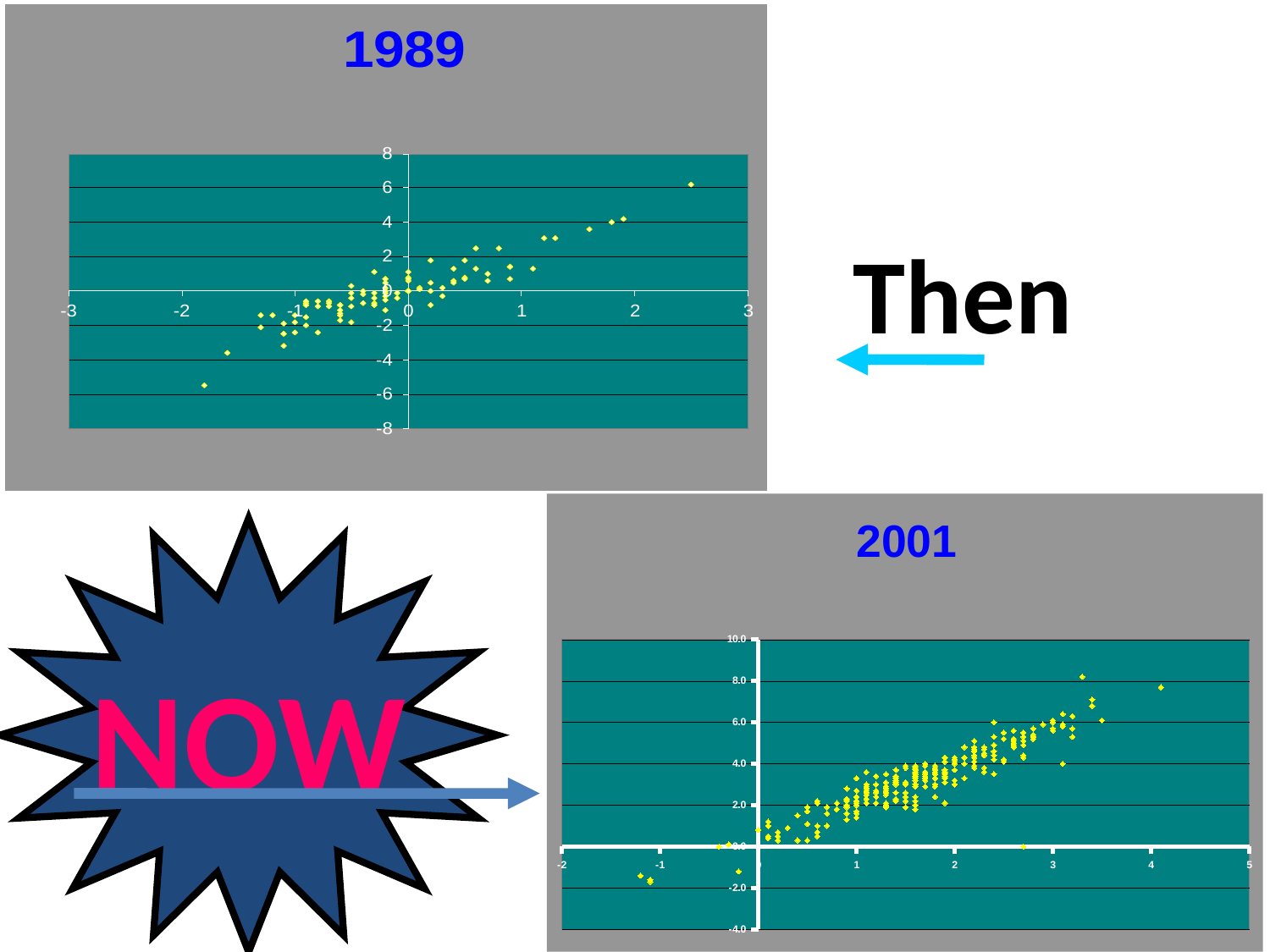
In the 2001 chart, is the y value of the highest point greater or less than 6.0? greater In the 1989 chart, is the y value of the highest point greater or less than 4? greater Which chart contains more plotted points, the 1989 chart or the 2001 chart? 2001 How many charts are shown on the slide? 2 What range does the x axis of the 1989 chart cover? -3 to 3 What kind of chart is the 1989 chart? scatter chart What kind of chart is the 2001 chart? scatter chart In the 1989 chart, is the y value of the lowest point greater or less than -4? less What range does the y axis of the 2001 chart cover? -4.0 to 10.0 In the 2001 chart, do the plotted values generally rise or fall as the x value increases? rise In the 1989 chart, do the plotted values generally rise or fall as the x value increases? rise